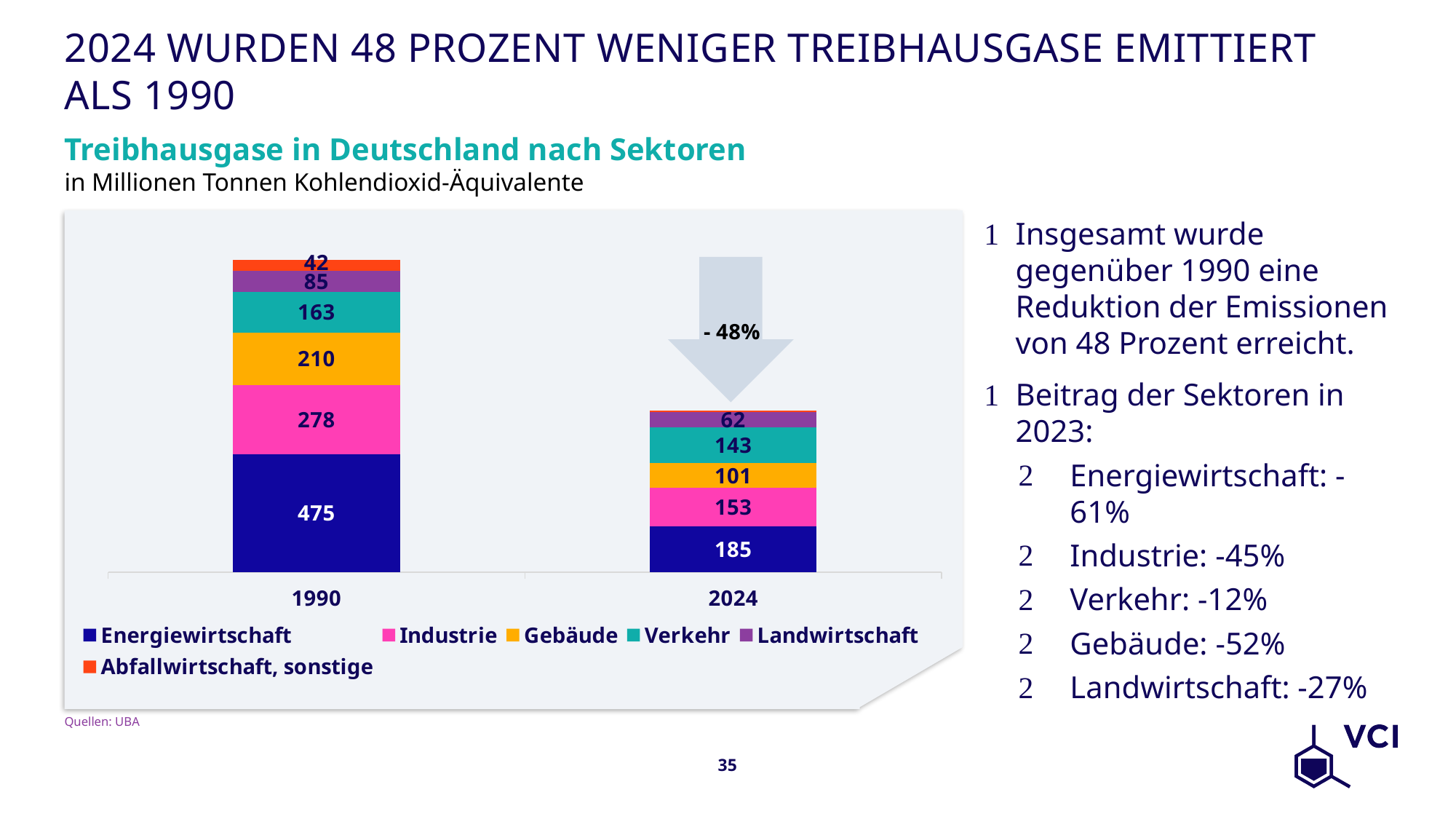
What is the total of the 1990 stacked bar? 1253 How many series does the legend list? 6 What is the value for Industrie in 2024? 153 What is the value for Verkehr in 2024? 143 What is the difference between the Energiewirtschaft values for 1990 and 2024? 290 Which sector has the largest value in the 1990 bar? Energiewirtschaft What is the value for Landwirtschaft in 1990? 85 What is the value for Energiewirtschaft in 1990? 475 What percentage change is shown by the arrow between the 1990 and 2024 bars? - 48% Which is larger: Gebäude in 1990 or Gebäude in 2024? Gebäude in 1990 Which sector has the smallest labelled value in the 2024 bar? Landwirtschaft What kind of chart is shown? Stacked bar chart